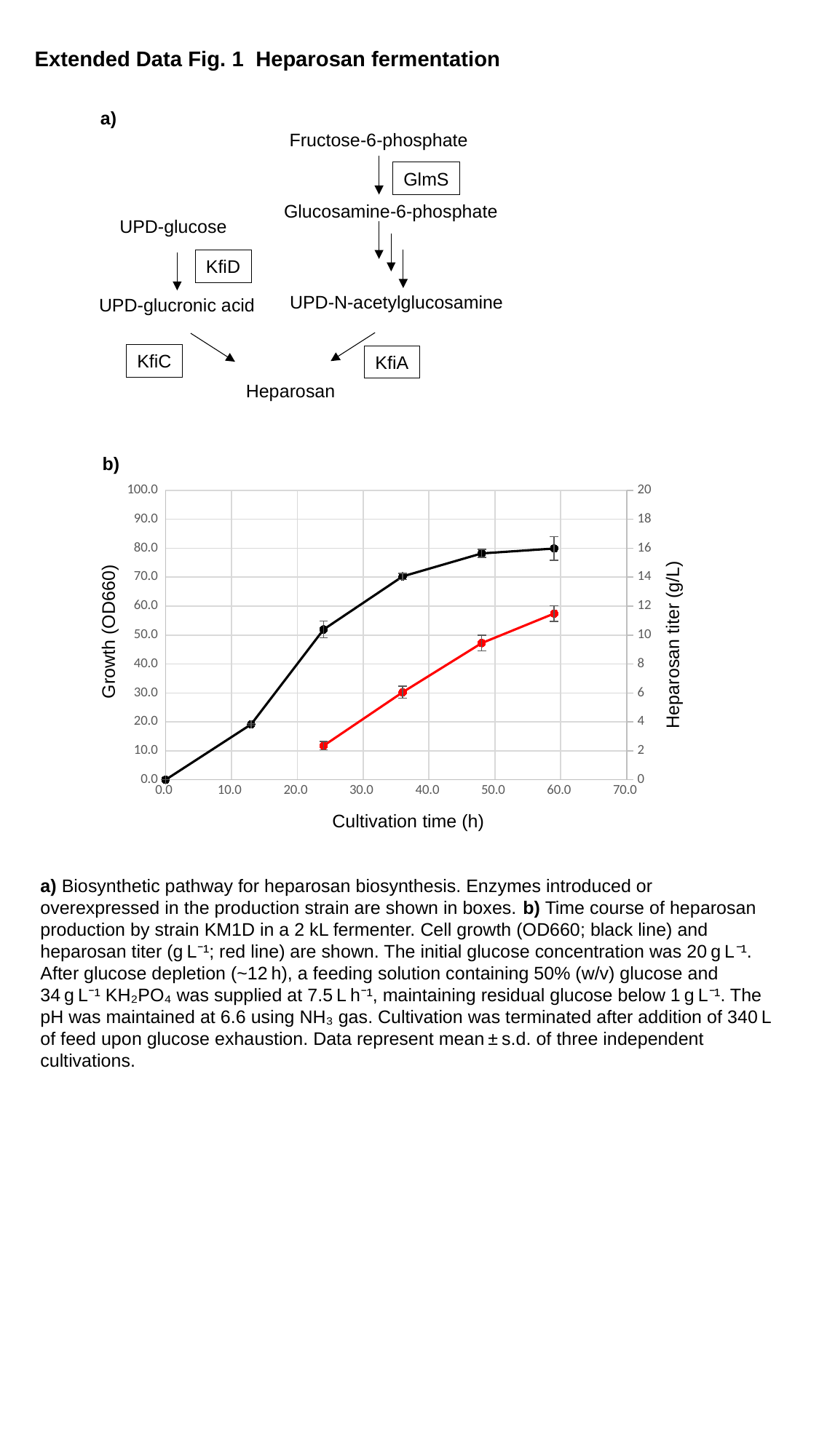
In panel b, is the growth (OD660) value at about 24 h greater or less than 40.0? greater In panel b, how many data points are plotted on the black growth line? 6 In panel b, is the final growth (OD660) value at about 59 h greater or less than 90.0? less In panel b, is the heparosan titer at about 59 h greater or less than 10 g/L? greater In panel b, what is the label of the right-hand y axis? Heparosan titer (g/L) In panel b, what is the growth (OD660) value at cultivation time 0.0 h? 0.0 In panel b, how many data points are plotted on the red heparosan titer line? 4 What kind of chart is shown in panel b? line chart In panel b, does the heparosan titer rise or fall as cultivation time increases? rise In panel b, what is the label of the x axis? Cultivation time (h)